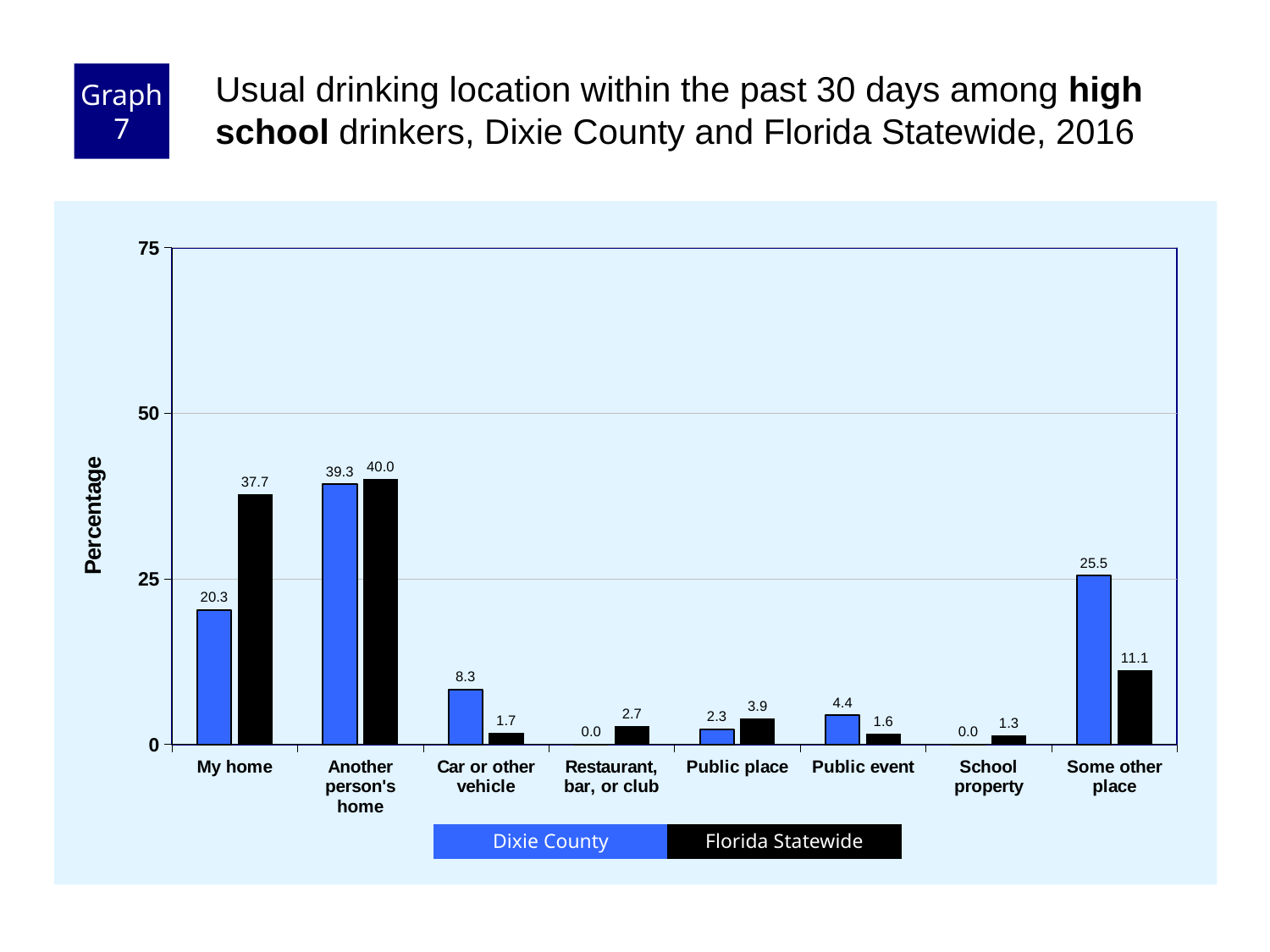
What is the Florida Statewide value for Some other place? 11.1 Which category has the lowest Florida Statewide value? School property How many categories are shown on the x axis? 8 What kind of chart is shown on the slide? Bar chart What is the Dixie County value for Car or other vehicle? 8.3 Is the Dixie County value for Some other place greater or less than 25? greater What is the label of the y axis? Percentage Which category has the highest Florida Statewide value? Another person's home What is the difference between the Florida Statewide and Dixie County values for My home? 17.4 What is the Dixie County value for My home? 20.3 Which is larger for Public event, the Dixie County value or the Florida Statewide value? Dixie County How many series does the legend list? 2